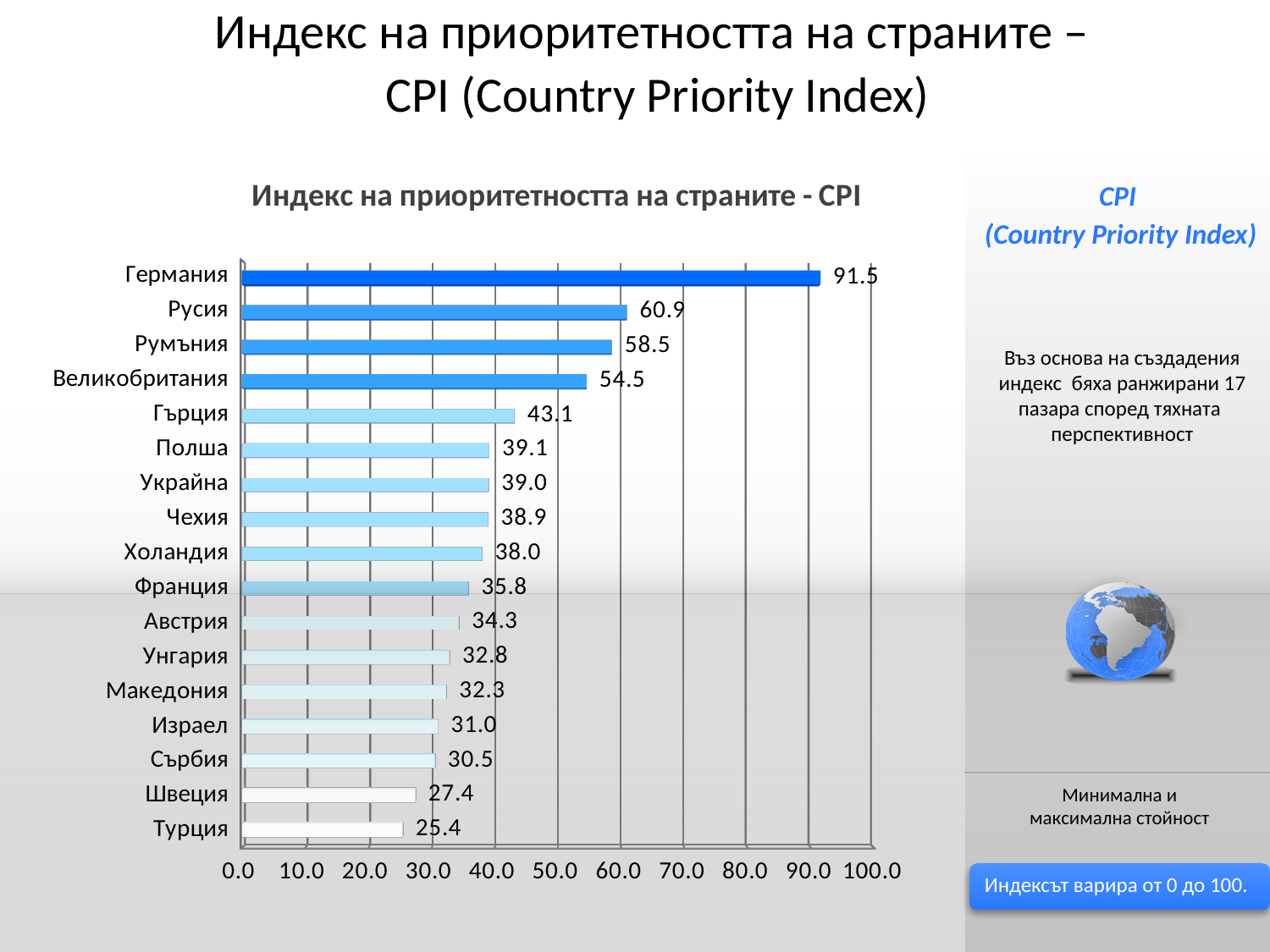
How many countries are shown in the chart? 17 What type of chart is shown on the slide? bar chart What is the difference between the CPI values of Русия and Румъния? 2.4 What is the title of the chart? Индекс на приоритетността на страните - CPI Which country has the highest CPI value? Германия Which has a higher CPI value, Великобритания or Полша? Великобритания What is the CPI value for Германия? 91.5 What is the maximum value shown on the x axis of the chart? 100.0 What is the CPI value for Гърция? 43.1 Is the value for Франция greater or less than 40.0? less What is the CPI value for Турция? 25.4 Which country has the lowest CPI value? Турция